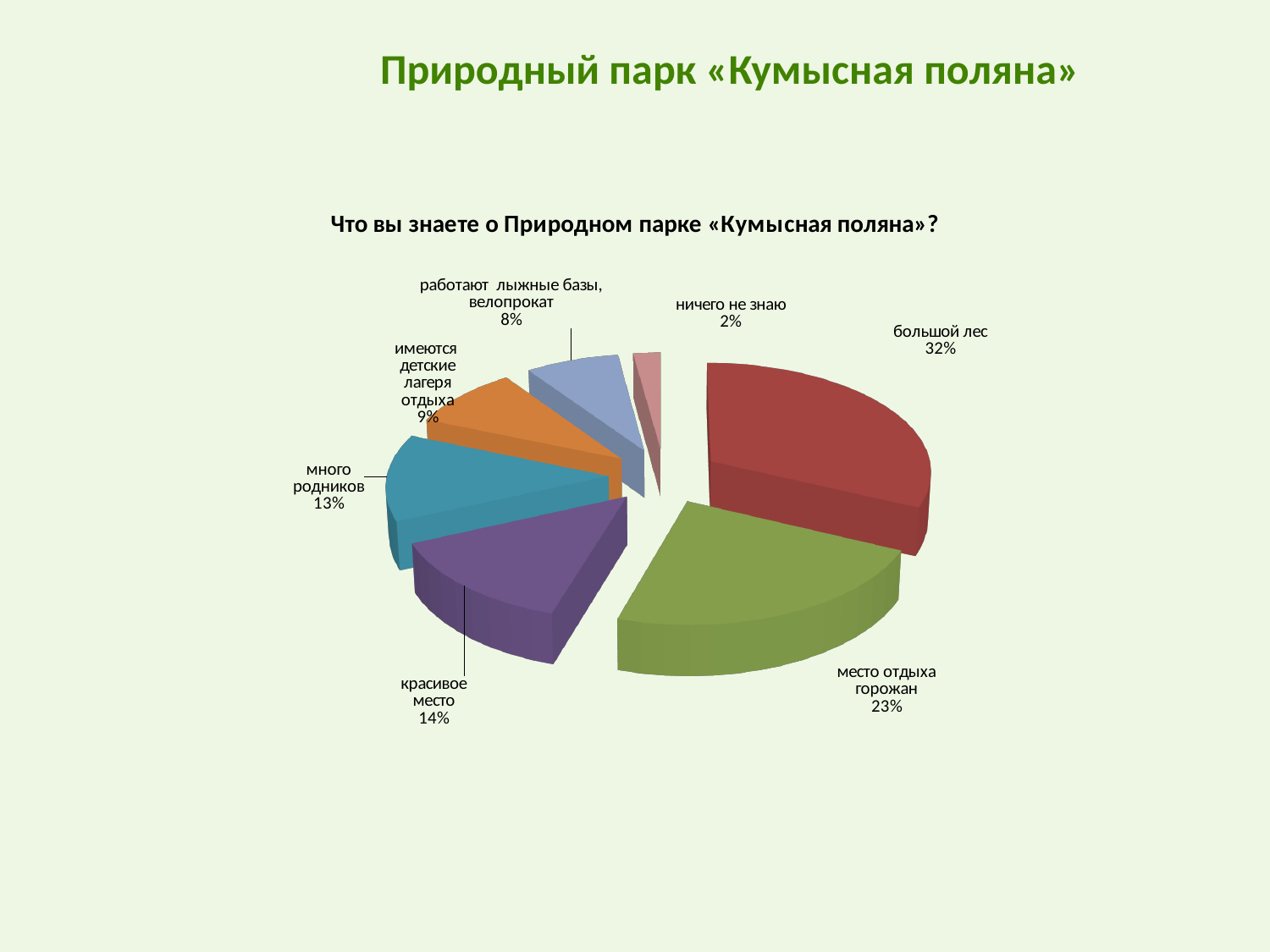
What kind of chart is shown on the slide? pie chart What share of the pie is labelled «много родников»? 13% Which slice of the pie is the smallest? ничего не знаю Which is larger: «красивое место» or «имеются детские лагеря отдыха»? красивое место What share of the pie is labelled «место отдыха горожан»? 23% What is the chart's title? Что вы знаете о Природном парке «Кумысная поляна»? What colour is the «большой лес» slice? red What share of the pie is labelled «ничего не знаю»? 2% What is the difference in percentage points between «большой лес» and «место отдыха горожан»? 9 Which slice of the pie is the largest? большой лес How many slices does the pie chart have? 7